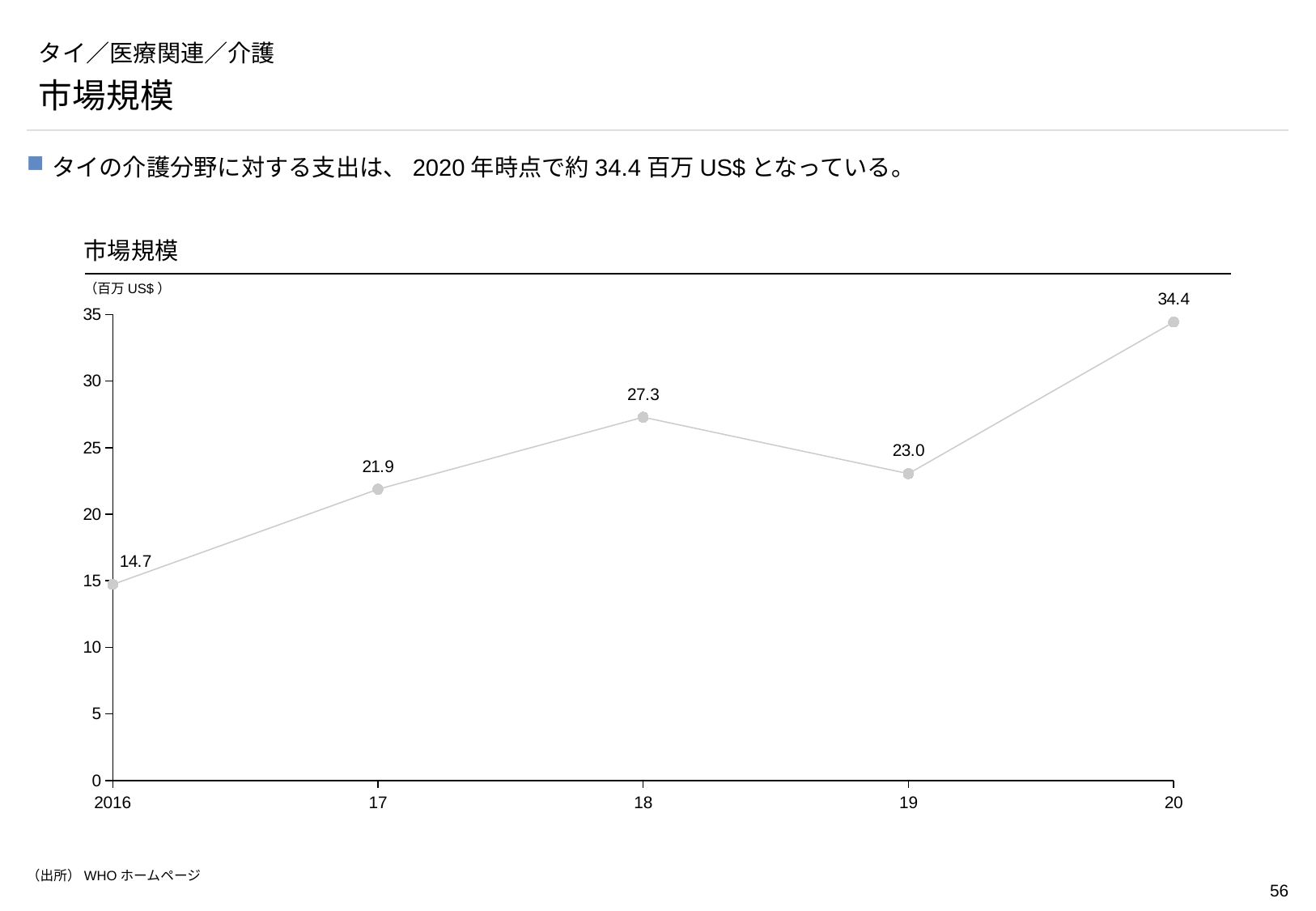
What is the difference between the market size in 2020 and in 2019? 11.4 What is the market size value for 2020? 34.4 What is the difference between the market size in 2018 and in 2017? 5.4 What unit is shown for the chart's values? 百万 US$ What is the market size value for 2016? 14.7 How many data points are plotted on the chart? 5 Which is larger, the market size in 2018 or in 2019? 2018 Does the market size rise or fall from 2018 to 2019? Fall What is the market size value for 2018? 27.3 What kind of chart is shown on the slide? Line chart Which year has the lowest market size? 2016 Which year has the highest market size? 2020